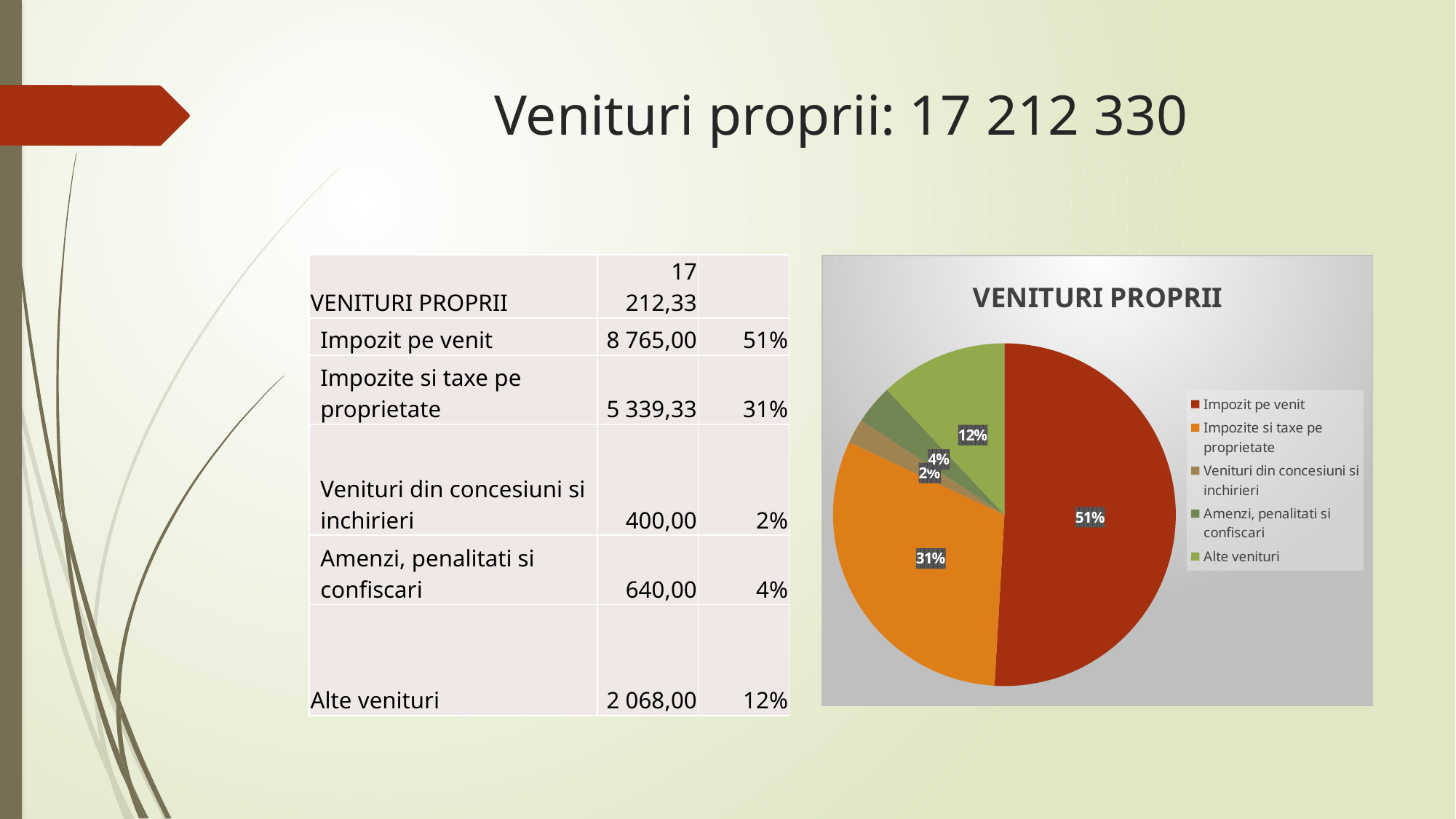
What type of chart is shown on the slide? Pie chart What share of the pie does Amenzi, penalitati si confiscari represent? 4% How many entries does the chart legend list? 5 How many slices does the pie chart have? 5 Which category has the largest slice of the pie? Impozit pe venit What is the title of the chart? VENITURI PROPRII What share of the pie does Alte venituri represent? 12% What share of the pie does Venituri din concesiuni si inchirieri represent? 2% Which category has the smallest slice of the pie? Venituri din concesiuni si inchirieri What is the difference in percentage points between the Impozit pe venit slice and the Impozite si taxe pe proprietate slice? 20 percentage points